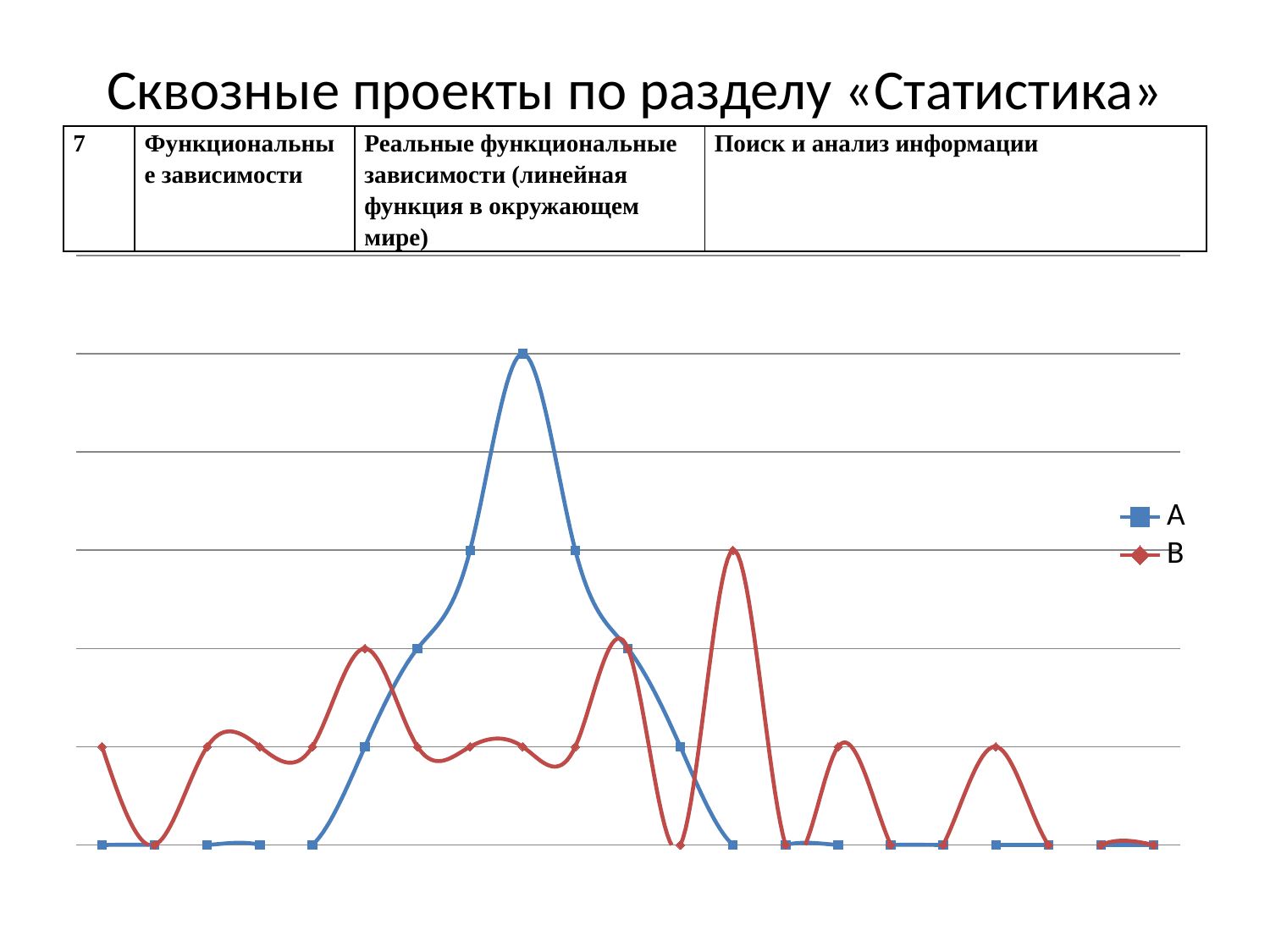
Which series has the higher value at the first (leftmost) point? B What kind of chart is shown on the slide? line chart Which series reaches the highest point on the chart? A What are the names of the series listed in the legend? A and B Which series is drawn in red? B How many data points does series A have? 21 How many series does the legend list? 2 Is the highest peak of series A higher or lower than the highest peak of series B? higher